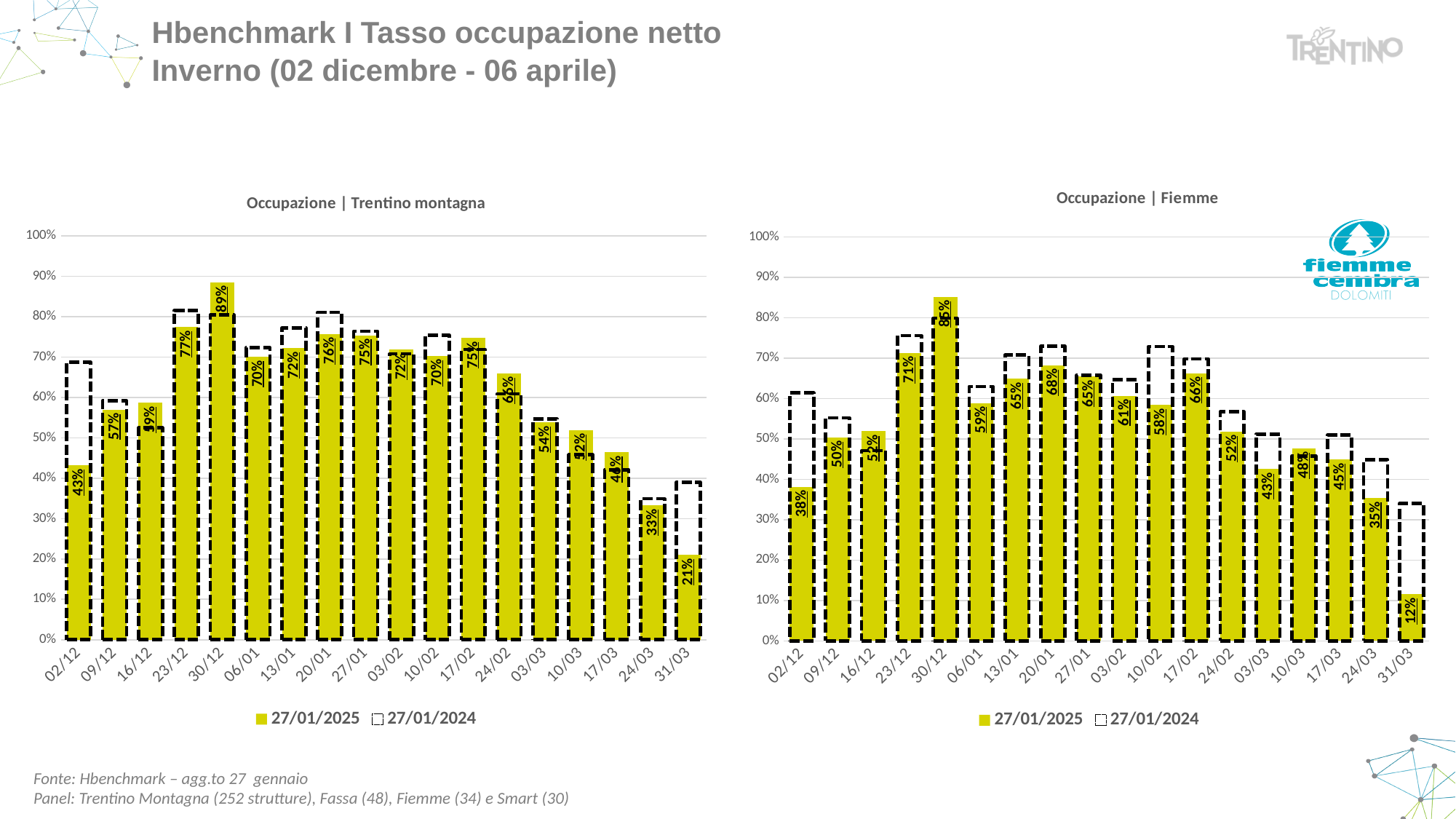
In the 'Occupazione | Fiemme' chart, which week has the lowest 27/01/2025 value? 31/03 In the 'Occupazione | Fiemme' chart, what is the 27/01/2025 value for 31/03? 12% In the 'Occupazione | Trentino montagna' chart, what is the 27/01/2025 value for 30/12? 89% In the 'Occupazione | Trentino montagna' chart, which 27/01/2025 value is larger, 02/12 or 09/12? 09/12 How many series does the legend of the 'Occupazione | Trentino montagna' chart list? 2 In the 'Occupazione | Trentino montagna' chart, which week has the highest 27/01/2025 value? 30/12 How many weeks are shown on the x axis of the 'Occupazione | Fiemme' chart? 18 In the 'Occupazione | Fiemme' chart, what is the 27/01/2025 value for 30/12? 85% In the 'Occupazione | Trentino montagna' chart, what is the difference between the 27/01/2025 values for 30/12 and 31/03? 68 percentage points What kind of chart is 'Occupazione | Fiemme'? Bar chart In the 'Occupazione | Trentino montagna' chart, is the 27/01/2024 value for 02/12 greater or less than 60%? greater In the 'Occupazione | Fiemme' chart, is the 27/01/2024 value for 31/03 greater or less than 40%? less